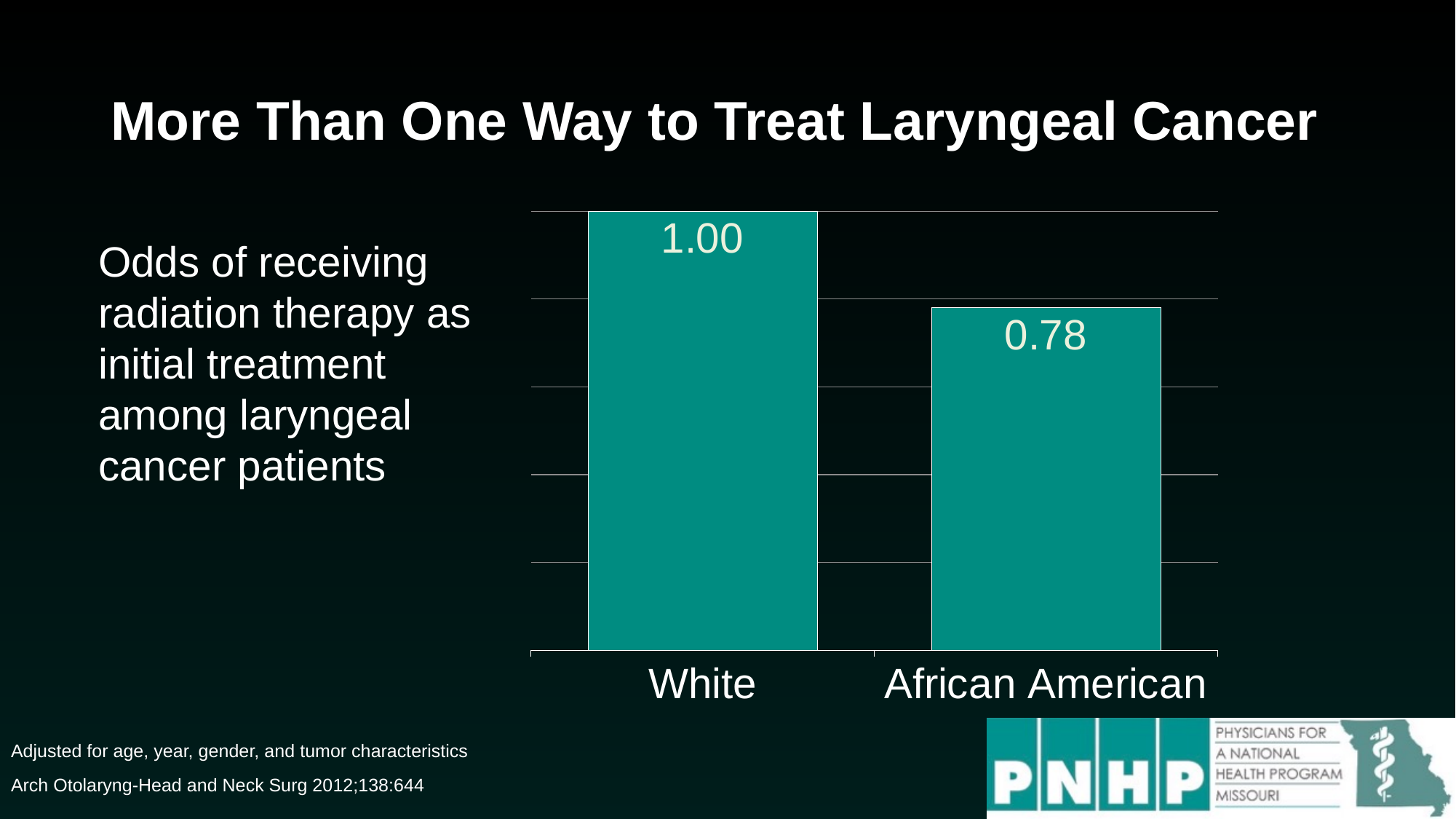
What does the chart show, according to the text on the left of the slide? Odds of receiving radiation therapy as initial treatment among laryngeal cancer patients Do the values rise or fall from White to African American? Fall What is the difference between the values for White and African American? 0.22 Which category has the highest value? White Which is larger, the value for White or the value for African American? White How many categories are shown in the chart? 2 What colour are the bars in the chart? Teal What is the value for African American? 0.78 What is the value for White? 1.00 Which category has the lowest value? African American What kind of chart is shown on the slide? Bar chart